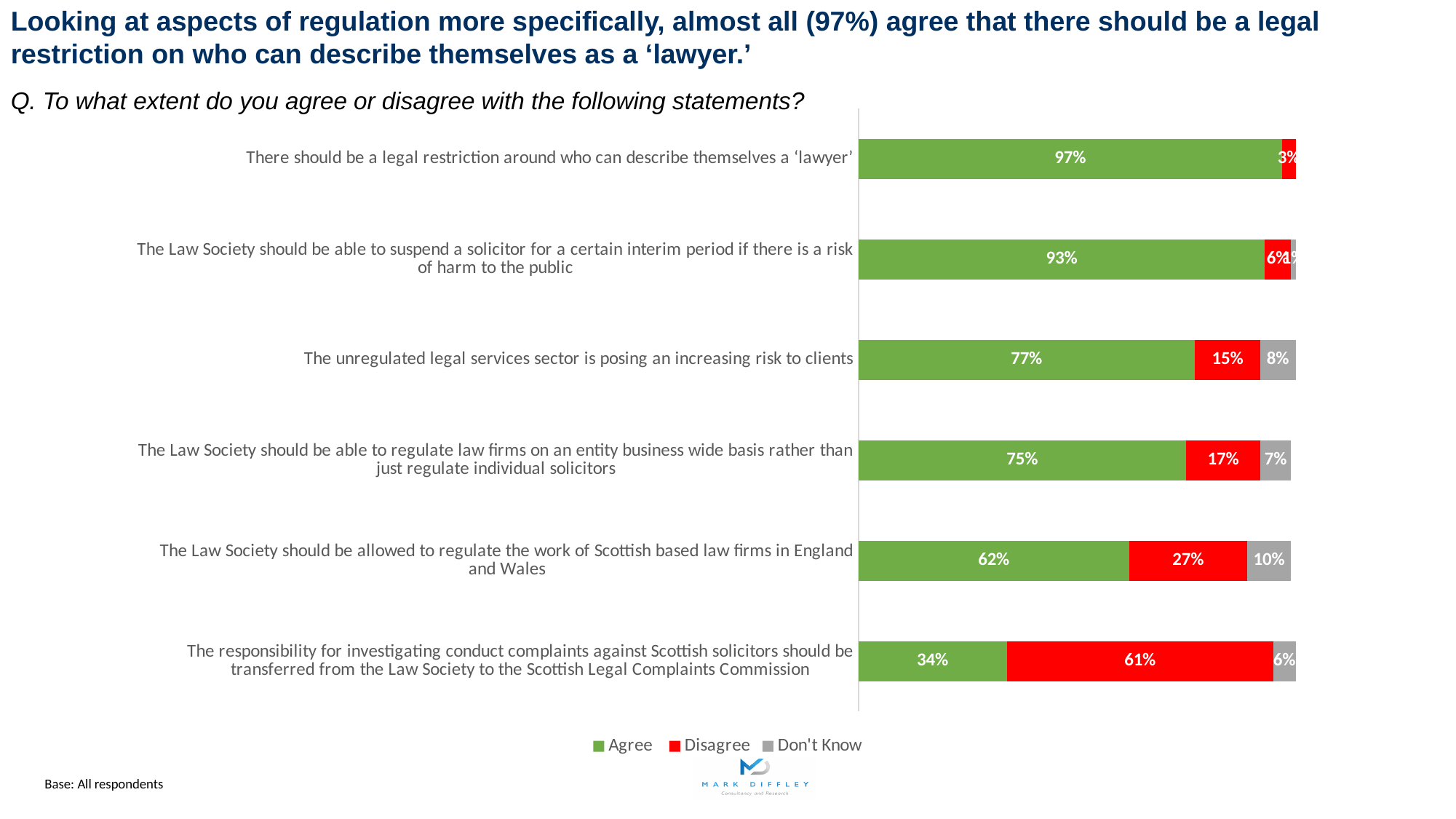
What percentage disagree that the unregulated legal services sector is posing an increasing risk to clients? 15% Which statement has the highest Agree percentage? There should be a legal restriction around who can describe themselves a 'lawyer' How many series does the legend list? 3 Which colour represents 'Disagree' in the chart? Red What percentage agree that there should be a legal restriction around who can describe themselves a 'lawyer'? 97% Which is larger: the Disagree percentage for regulating Scottish based law firms in England and Wales, or the Disagree percentage for regulating law firms on an entity business wide basis? Regulating Scottish based law firms in England and Wales (27%) What is the difference between the Agree percentage for the statement about suspending a solicitor for an interim period (93%) and the statement about regulating law firms on an entity basis (75%)? 18% What type of chart is shown on the slide? Stacked bar chart How many statements are shown in the chart? 6 What percentage answered 'Don't Know' for the statement that the Law Society should be allowed to regulate the work of Scottish based law firms in England and Wales? 10% Which statement has the lowest Agree percentage? The responsibility for investigating conduct complaints against Scottish solicitors should be transferred from the Law Society to the Scottish Legal Complaints Commission What percentage agree that the responsibility for investigating conduct complaints should be transferred from the Law Society to the Scottish Legal Complaints Commission? 34%